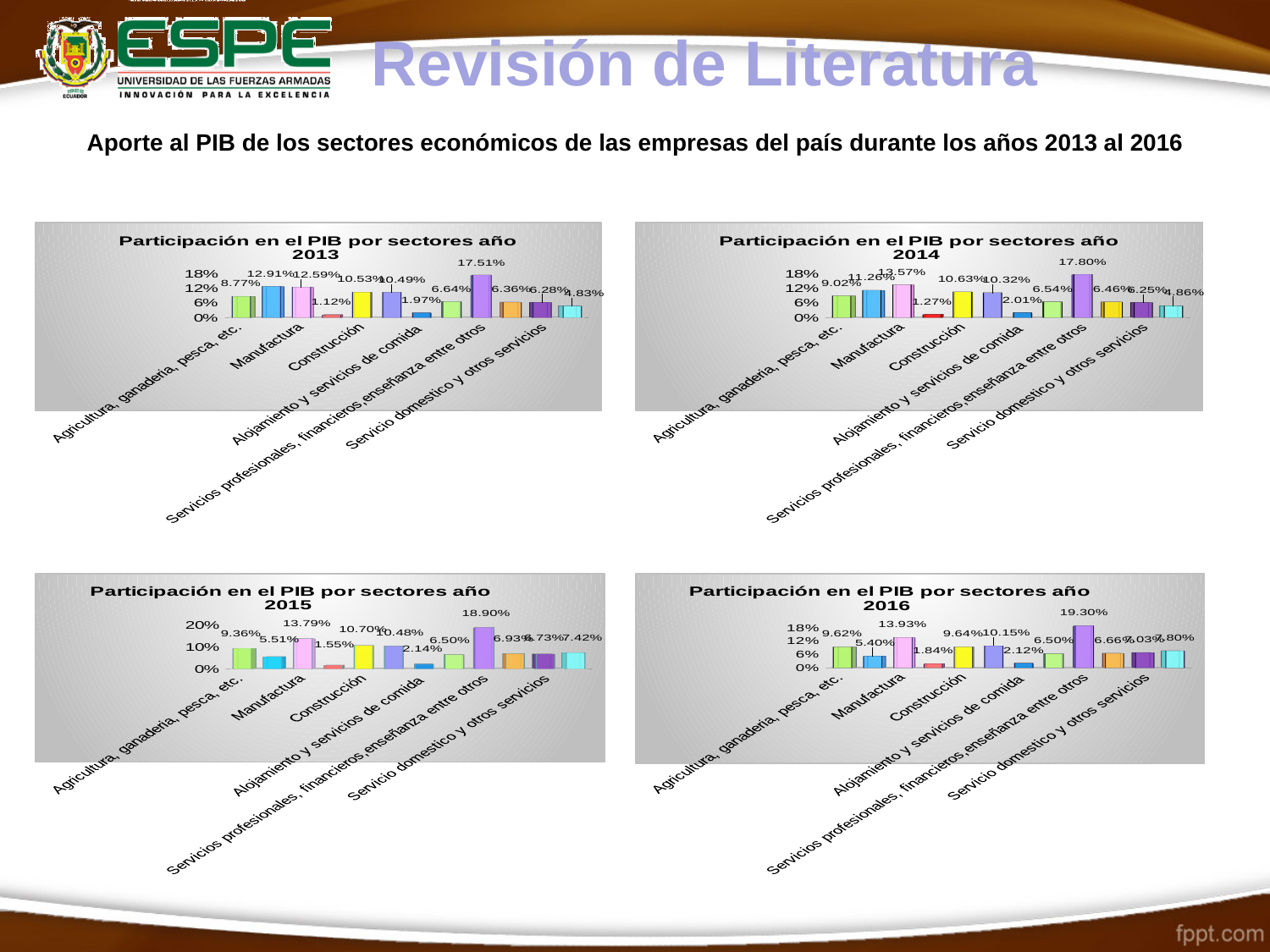
In the 'Participación en el PIB por sectores año 2013' chart, what is the highest value shown? 17.51% In the 'Participación en el PIB por sectores año 2016' chart, what is the lowest value shown? 1.84% In the 'Participación en el PIB por sectores año 2013' chart, what is the lowest value shown? 1.12% In the 'Participación en el PIB por sectores año 2015' chart, what is the highest value shown? 18.90% In the 'Participación en el PIB por sectores año 2016' chart, what is the highest value shown? 19.30% In the 'Participación en el PIB por sectores año 2015' chart, is the value for Agricultura, ganadería, pesca, etc. greater or less than 10%? less What type of chart is the 'Participación en el PIB por sectores año 2014' chart? Bar chart How many bars are plotted in the 'Participación en el PIB por sectores año 2015' chart? 12 In the 'Participación en el PIB por sectores año 2016' chart, what is the value for Agricultura, ganadería, pesca, etc.? 9.62% In the 'Participación en el PIB por sectores año 2013' chart, what is the value for Agricultura, ganadería, pesca, etc.? 8.77% How many charts are shown on the slide? 4